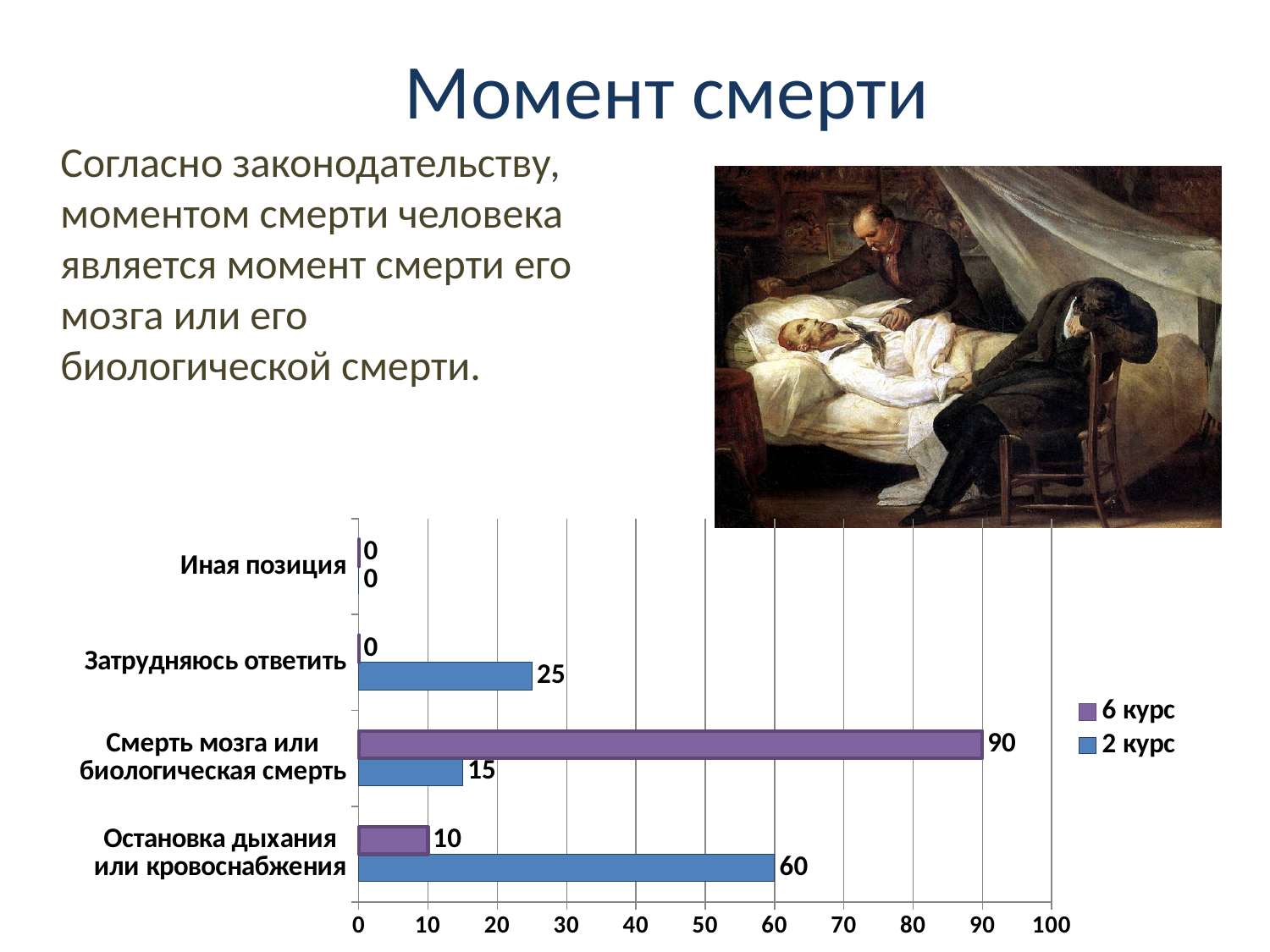
How many series does the chart legend list? 2 What is the value for "6 курс" in the category "Смерть мозга или биологическая смерть"? 90 What is the difference between the "6 курс" and "2 курс" values for "Смерть мозга или биологическая смерть"? 75 What is the value for "2 курс" in the category "Затрудняюсь ответить"? 25 What is the value for "6 курс" in the category "Остановка дыхания или кровоснабжения"? 10 Which is larger for "Остановка дыхания или кровоснабжения": the value for "6 курс" or for "2 курс"? 2 курс Which category has the highest value for "2 курс"? Остановка дыхания или кровоснабжения What kind of chart is shown on the slide? bar chart What is the value for "2 курс" in the category "Остановка дыхания или кровоснабжения"? 60 How many categories are shown on the chart? 4 Which category has the highest value for "6 курс"? Смерть мозга или биологическая смерть Which series is shown in purple in the legend? 6 курс